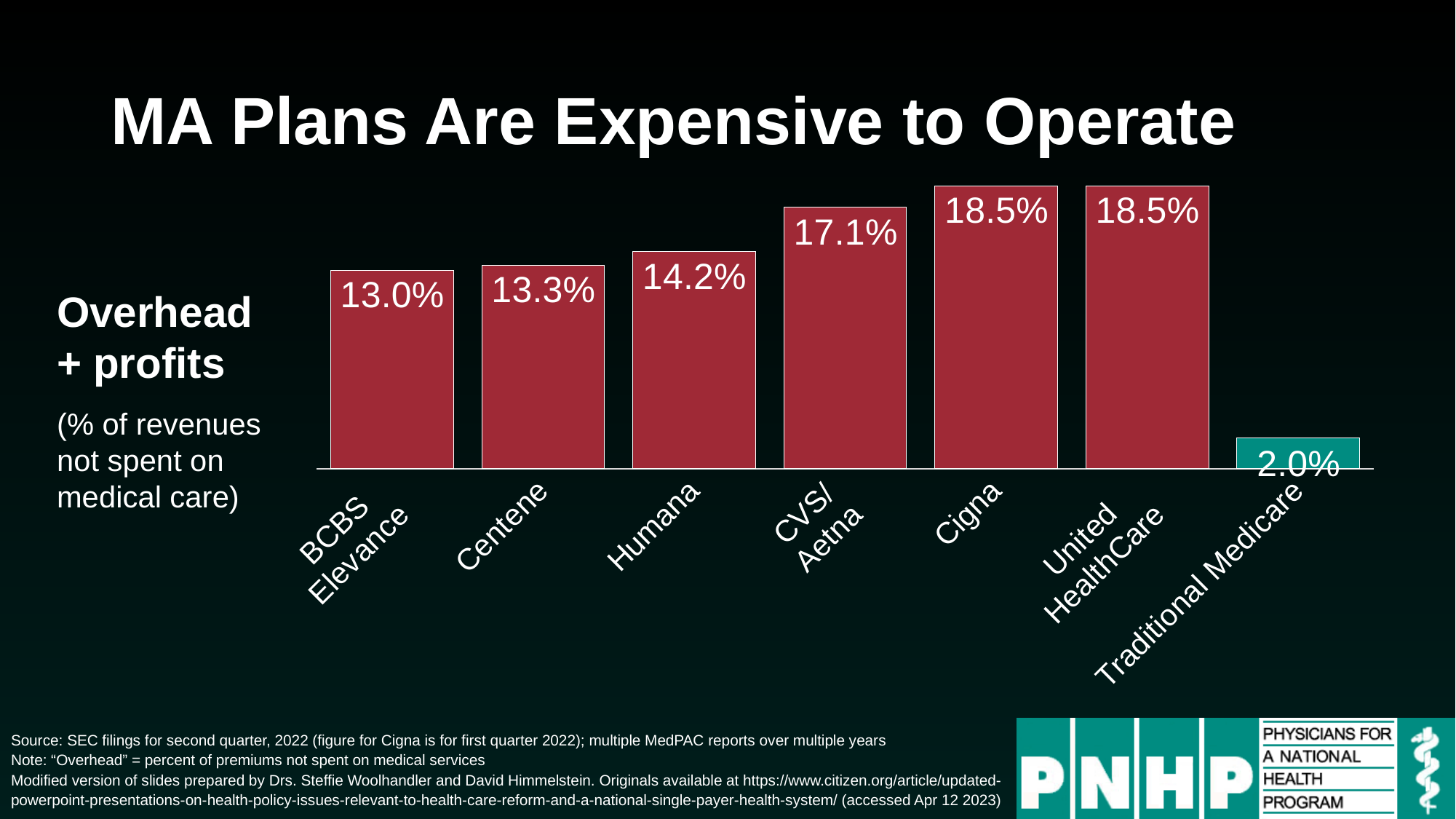
What is the difference between the values for Centene and BCBS Elevance? 0.3% Which is larger, the value for Humana or the value for CVS/Aetna? CVS/Aetna Do the values for the MA plans rise or fall from BCBS Elevance to United HealthCare? Rise What is the difference between the values for Cigna and Traditional Medicare? 16.5% Which bar is shown in a different colour (teal) from the others? Traditional Medicare Which category has the lowest overhead + profits value? Traditional Medicare What is the overhead + profits value for Traditional Medicare? 2.0% What kind of chart is shown on the slide? Bar chart Which two categories share the highest value of 18.5%? Cigna and United HealthCare What is the overhead + profits value for CVS/Aetna? 17.1% How many categories are shown on the chart? 7 What is the overhead + profits value for Humana? 14.2%